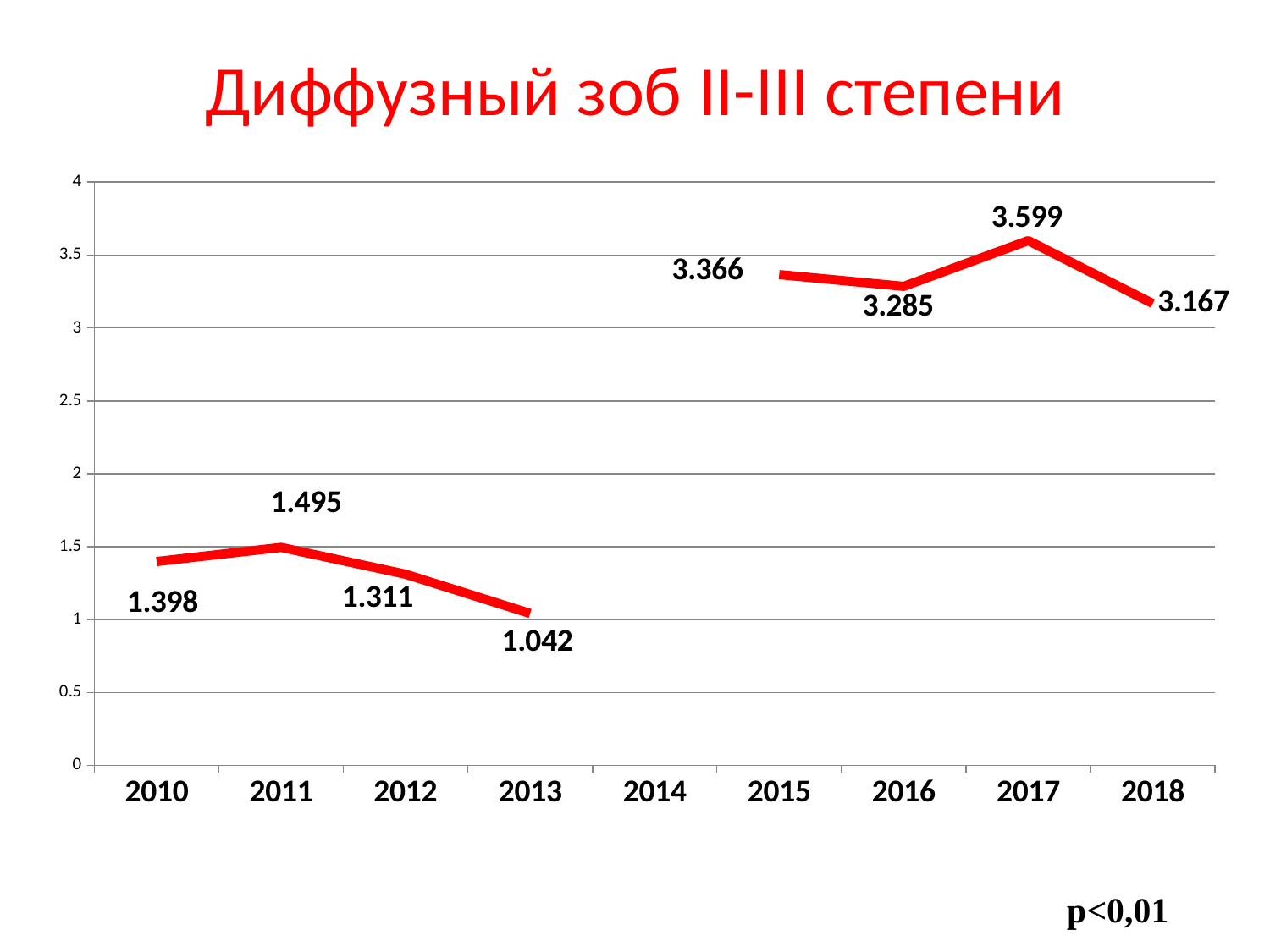
Which year has the lowest value? 2013 What is the difference between the values for 2017 and 2016? 0.314 What is the value for 2017? 3.599 Which is larger, the value for 2011 or the value for 2012? 2011 How many years have a data label on the chart? 8 What kind of chart is shown? line chart What is the title of the chart? Диффузный зоб II-III степени What is the value for 2013? 1.042 What is the value for 2010? 1.398 Do the values rise or fall from 2011 to 2013? fall Is the value for 2015 greater or less than 3? greater Which year has the highest value? 2017